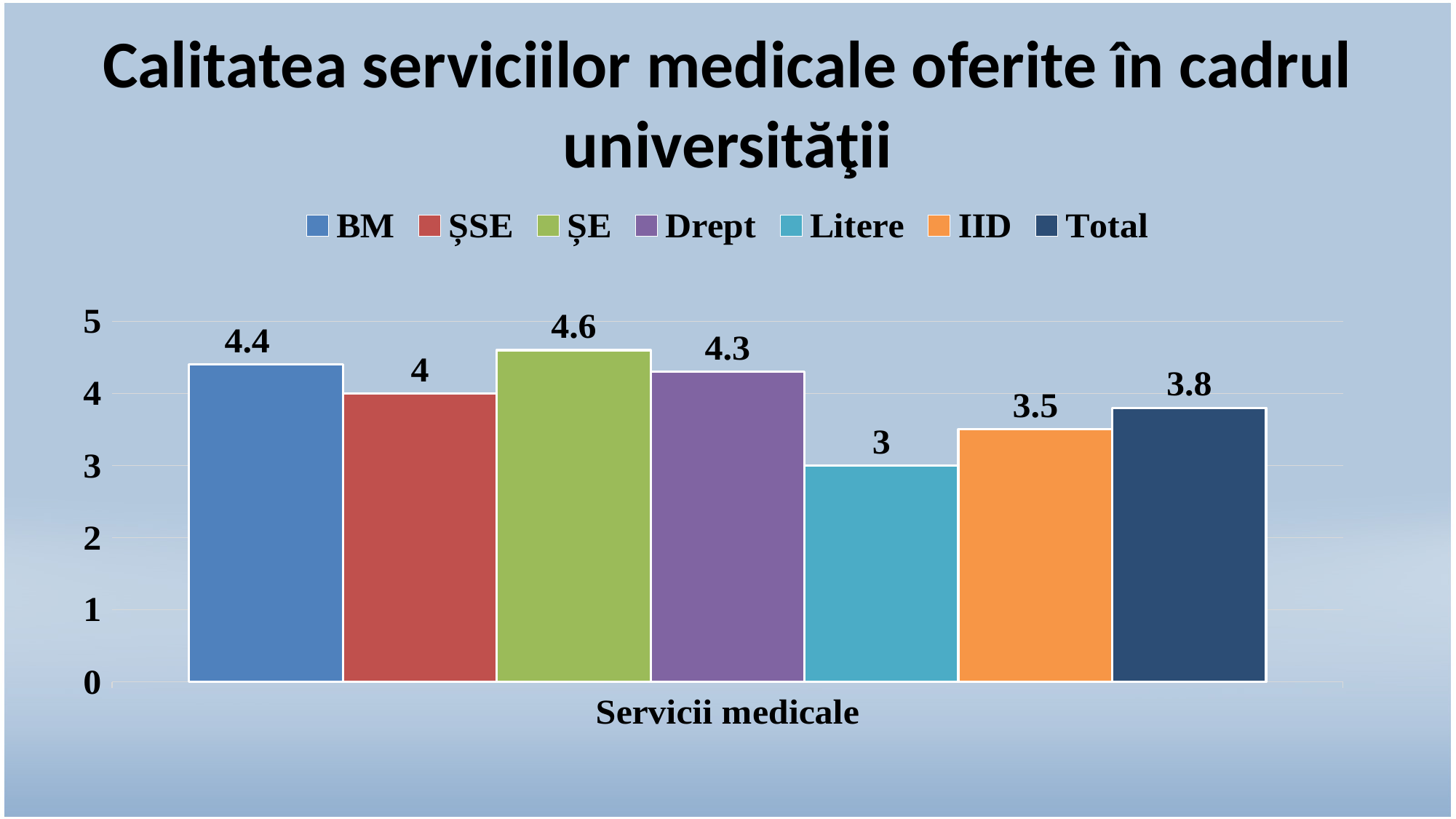
Which series has the lowest value? Litere What kind of chart is shown on the slide? bar chart What is the difference between the values for ȘE and Litere? 1.6 Which series has the highest value? ȘE What is the difference between the values for BM and Total? 0.6 What is the value for BM? 4.4 What is the value for Total? 3.8 What is the value for Litere? 3 What is the label on the x axis? Servicii medicale How many series does the legend list? 7 What colour is the bar for IID? orange Which is larger, the value for Drept or the value for IID? Drept